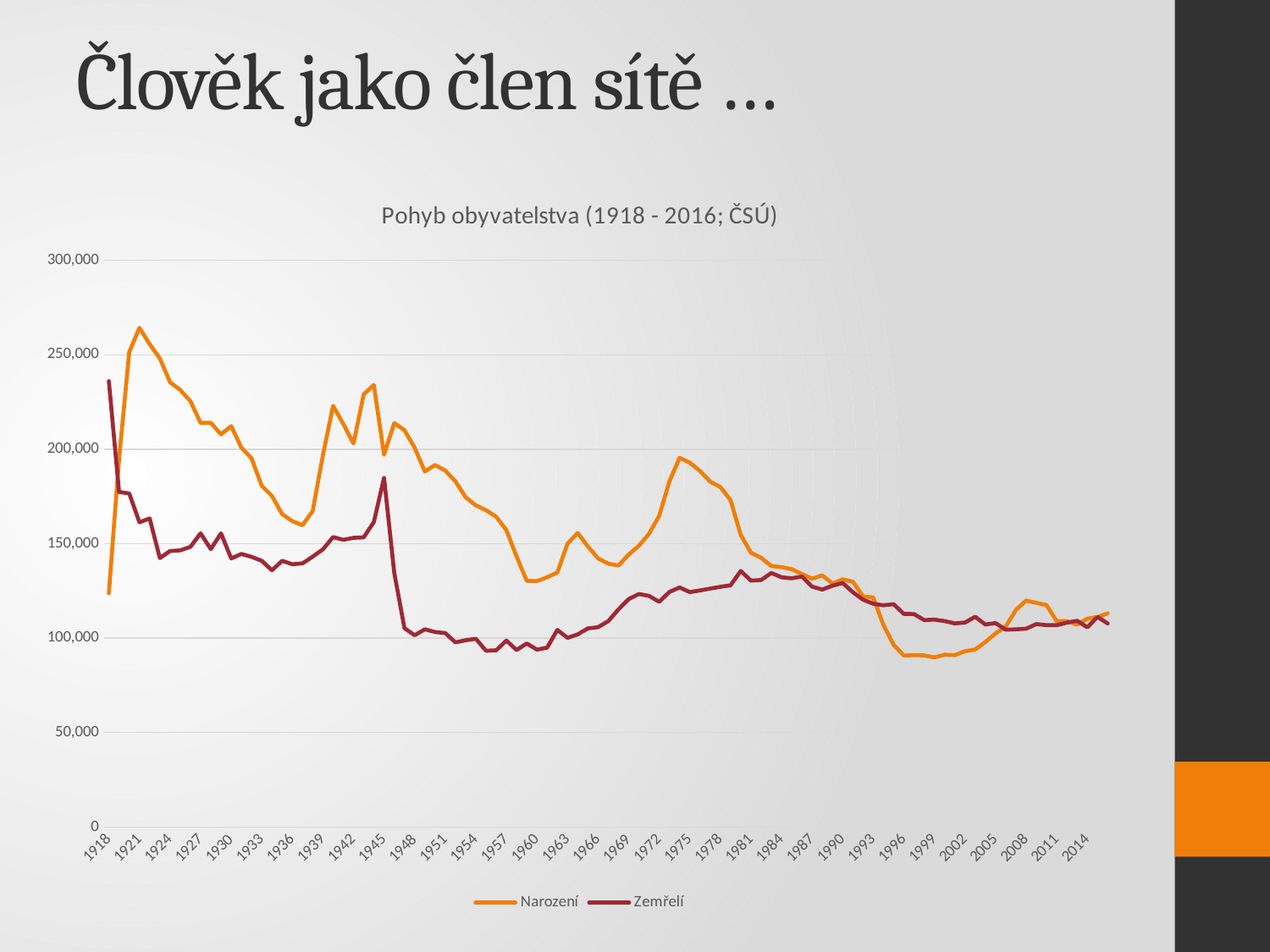
Is the value for Zemřelí in 1918 greater or less than 200,000? greater Is the value for Narození in 1996 greater or less than 100,000? less How many series does the legend list? 2 In 1921, which series has the larger value, Narození or Zemřelí? Narození Is the value for Narození in 1921 greater or less than 250,000? greater In 1996, which series has the larger value, Narození or Zemřelí? Zemřelí Does the Narození series rise or fall between 1975 and 1996? fall What is the title of the chart? Pohyb obyvatelstva (1918 - 2016; ČSÚ) In 1918, which series has the larger value, Narození or Zemřelí? Zemřelí Which colour is used for the Narození series? orange What kind of chart is shown on the slide? line chart